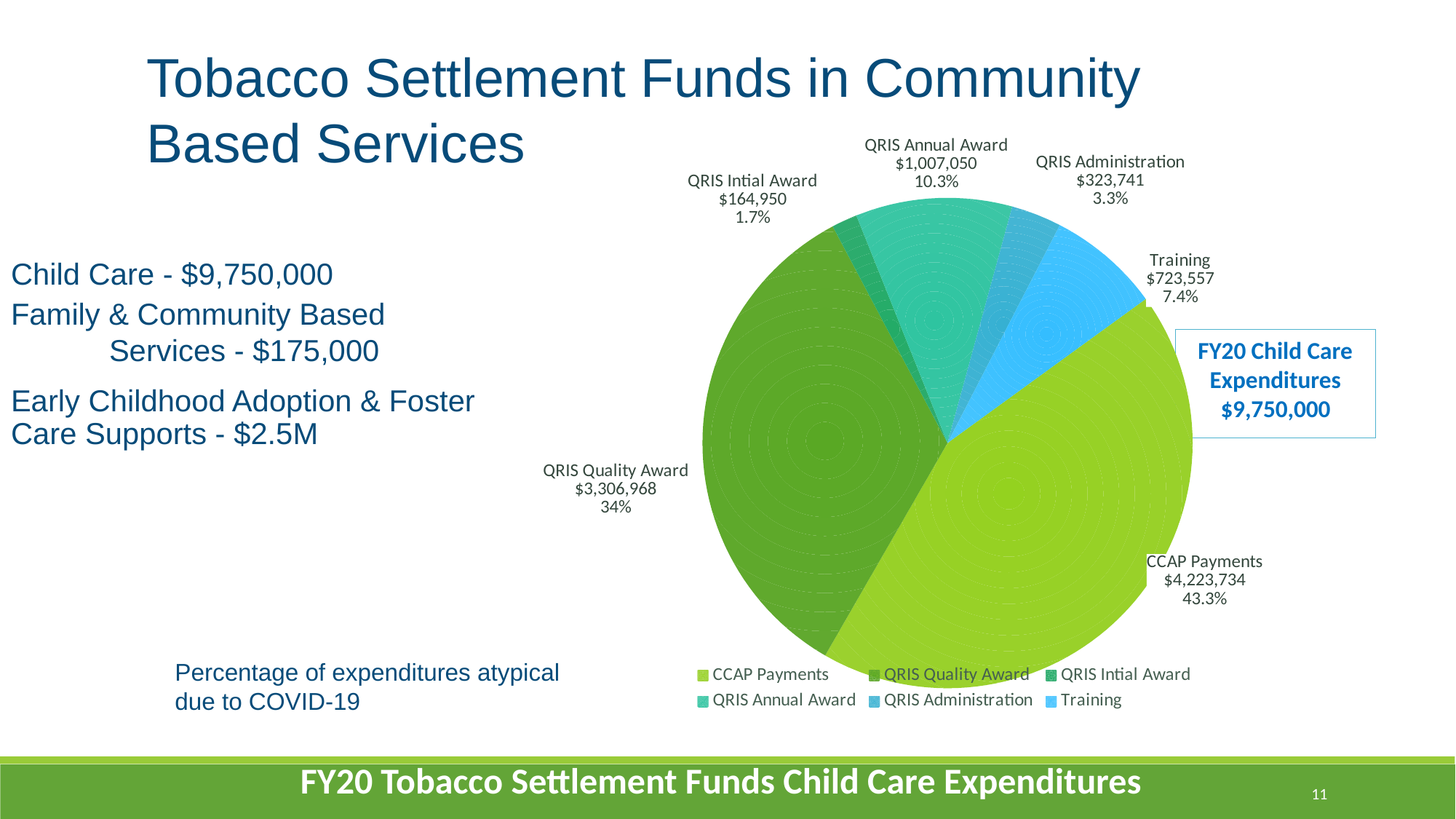
What kind of chart is shown on the slide? Pie chart What is the difference between Training and QRIS Administration? $399,816 What is the value for Training? $723,557 What total is shown in the FY20 Child Care Expenditures box next to the chart? $9,750,000 Which category has the smallest slice? QRIS Intial Award What is the difference between CCAP Payments and QRIS Quality Award? $916,766 Which category has the largest slice? CCAP Payments How many categories does the pie chart show? 6 What percentage share does QRIS Quality Award have? 34% What is the value for CCAP Payments? $4,223,734 What percentage share does QRIS Annual Award have? 10.3% Which is larger, QRIS Administration or Training? Training